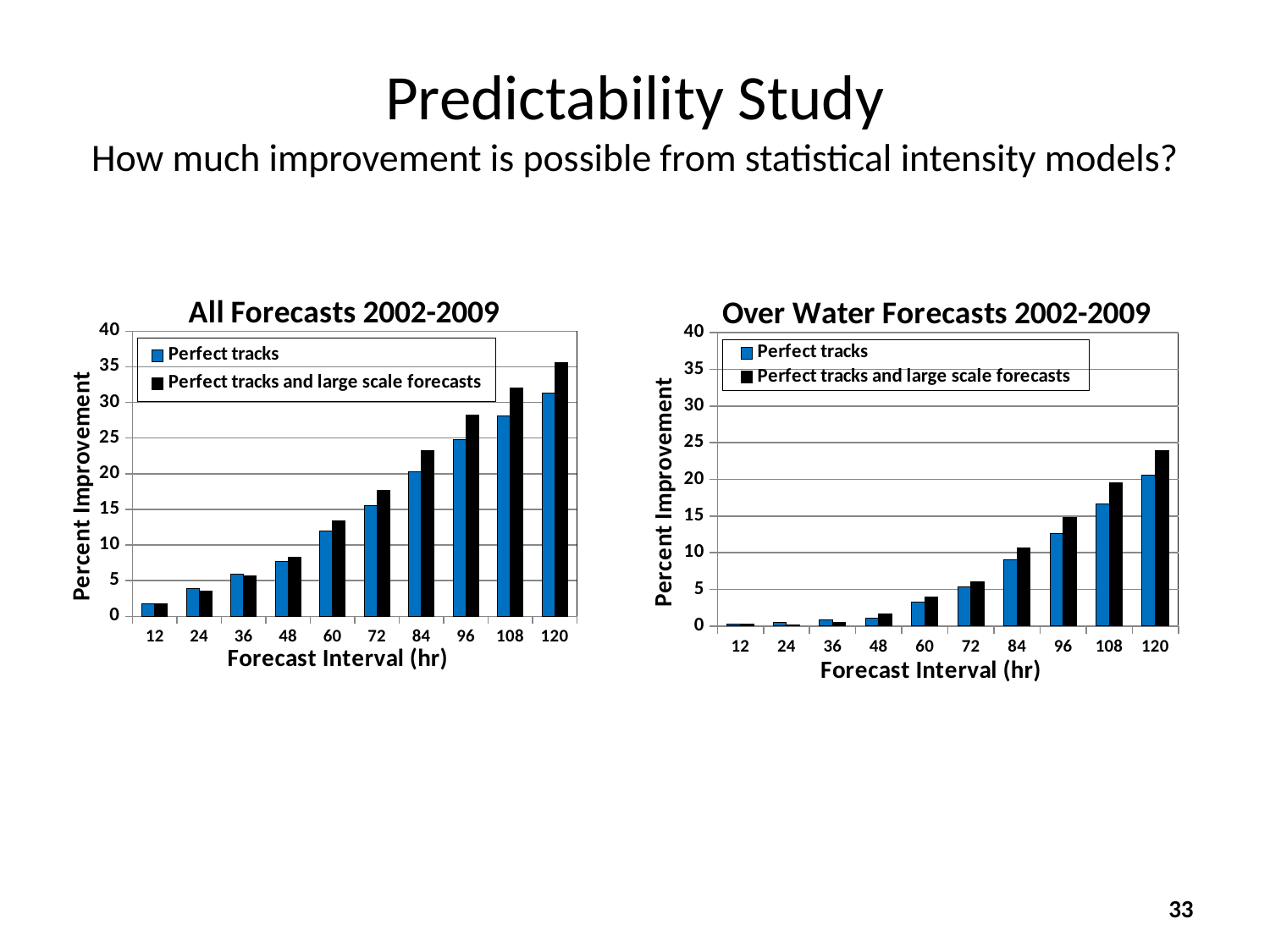
In the All Forecasts 2002-2009 chart, at which forecast interval is the Perfect tracks and large scale forecasts value lowest? 12 In the Over Water Forecasts 2002-2009 chart, what colour are the Perfect tracks bars? blue In the All Forecasts 2002-2009 chart, do the Perfect tracks values rise or fall as the forecast interval increases? rise In the All Forecasts 2002-2009 chart, at which forecast interval is the Perfect tracks value highest? 120 In the All Forecasts 2002-2009 chart, is the Perfect tracks value at 120 hr greater or less than 30? greater In the Over Water Forecasts 2002-2009 chart, which series has the larger value at 120 hr? Perfect tracks and large scale forecasts In the All Forecasts 2002-2009 chart, how many forecast intervals are shown on the x axis? 10 In the Over Water Forecasts 2002-2009 chart, what is the label of the y axis? Percent Improvement In the All Forecasts 2002-2009 chart, how many series does the legend list? 2 In the All Forecasts 2002-2009 chart, what kind of chart is shown? bar chart In the Over Water Forecasts 2002-2009 chart, is the Perfect tracks value at 84 hr greater or less than 10? less In the All Forecasts 2002-2009 chart, is the Perfect tracks value at 60 hr greater or less than 10? greater